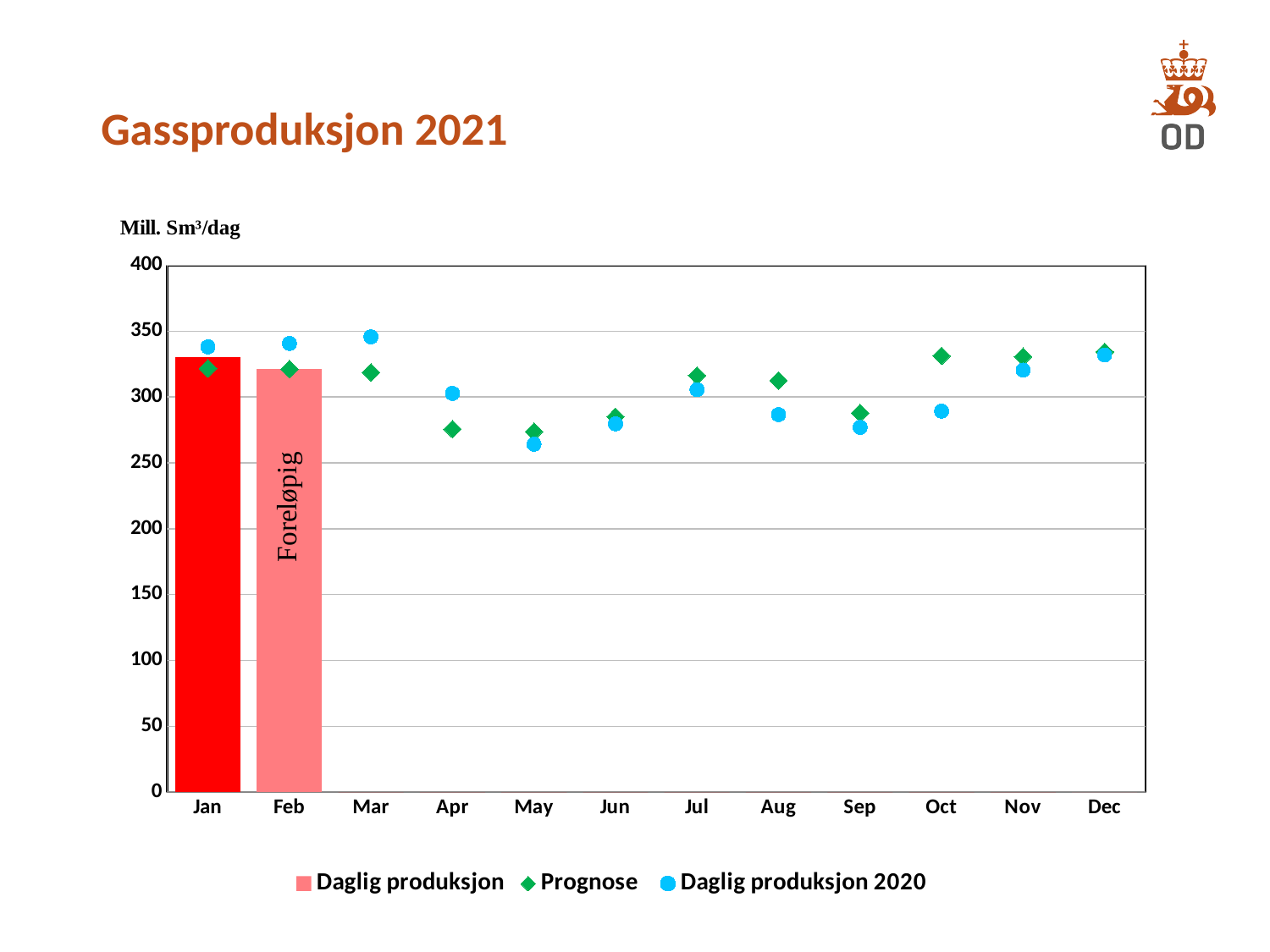
How many series does the legend list? 3 How many bars for Daglig produksjon are plotted? 2 What unit is shown above the y axis? Mill. Sm³/dag For Oct, which is larger: the Prognose value or the Daglig produksjon 2020 value? Prognose How many months are shown on the x axis? 12 Does the Prognose series rise or fall from Jan to May? fall For Mar, which is larger: the Prognose value or the Daglig produksjon 2020 value? Daglig produksjon 2020 Is the Prognose value for Apr greater or less than 300? less In which month is the Daglig produksjon 2020 value highest? Mar Is the Daglig produksjon bar for Jan greater or less than 300? greater Is the Daglig produksjon 2020 value for May greater or less than 300? less In which month is the Daglig produksjon 2020 value lowest? May